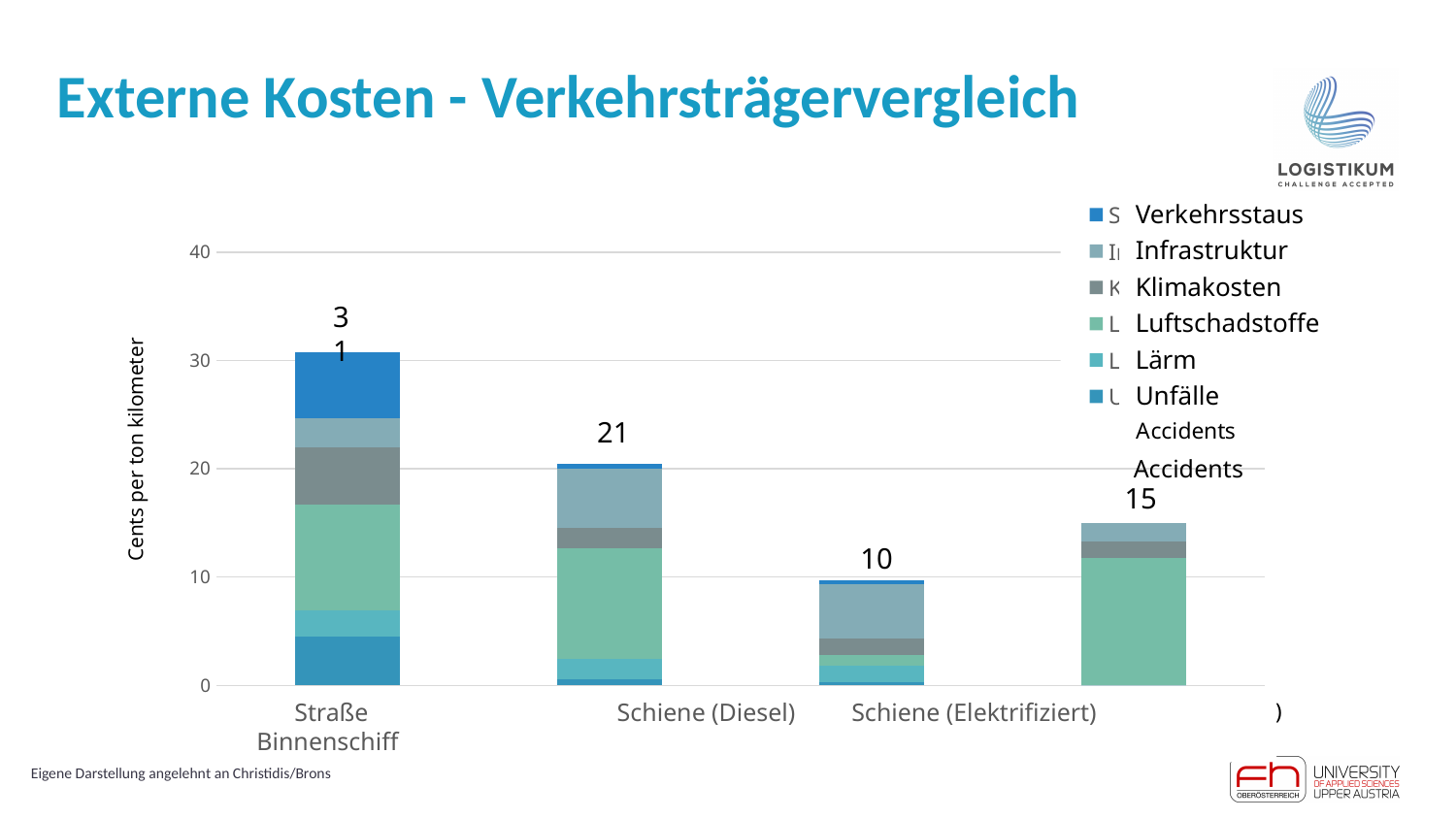
What kind of chart is shown on the slide? Stacked bar chart What is the difference between the totals for Schiene (Diesel) and Schiene (Elektrifiziert)? 11 What is the total value labelled above the Schiene (Diesel) bar? 21 How many series does the legend list? 6 What is the total value labelled above the Schiene (Elektrifiziert) bar? 10 What is the title of the vertical axis? Cents per ton kilometer How many bars are plotted in the chart? 4 Which category has the highest total external cost? Straße Is the total for Schiene (Diesel) greater or less than 20? greater What is the total value labelled above the rightmost bar? 15 Which category has the lowest total external cost? Schiene (Elektrifiziert)